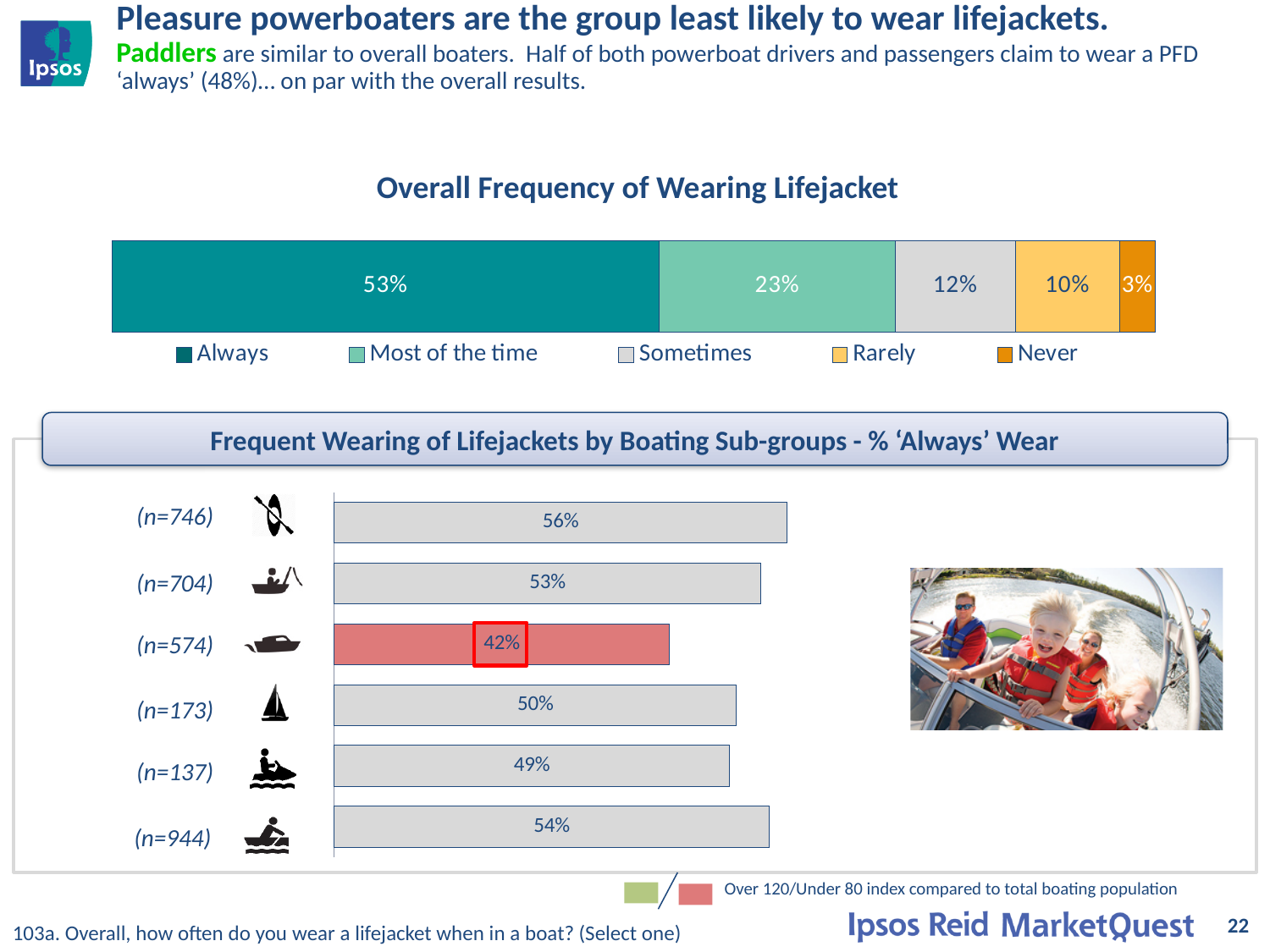
In the 'Overall Frequency of Wearing Lifejacket' chart, what percentage is shown for 'Never'? 3% In the 'Overall Frequency of Wearing Lifejacket' chart, what is the difference between the 'Most of the time' and 'Sometimes' percentages? 11% In the 'Overall Frequency of Wearing Lifejacket' chart, how many categories does the legend list? 5 In the 'Frequent Wearing of Lifejackets by Boating Sub-groups' chart, which group has the lowest '% Always' value? n=574 (42%) What type of chart is the 'Frequent Wearing of Lifejackets by Boating Sub-groups' chart? Bar chart In the 'Frequent Wearing of Lifejackets by Boating Sub-groups' chart, which group has the highest '% Always' value? n=746 (56%) In the 'Overall Frequency of Wearing Lifejacket' chart, which category has the smallest share? Never In the 'Overall Frequency of Wearing Lifejacket' chart, what percentage of boaters say they 'Always' wear a lifejacket? 53% In the 'Frequent Wearing of Lifejackets by Boating Sub-groups' chart, how many sub-groups (bars) are shown? 6 In the 'Frequent Wearing of Lifejackets by Boating Sub-groups' chart, what is the '% Always' value for the group with n=574? 42% In the 'Frequent Wearing of Lifejackets by Boating Sub-groups' chart, what is the value for the group with n=944? 54% In the 'Frequent Wearing of Lifejackets by Boating Sub-groups' chart, what is the difference between the values for the n=746 group and the n=574 group? 14%